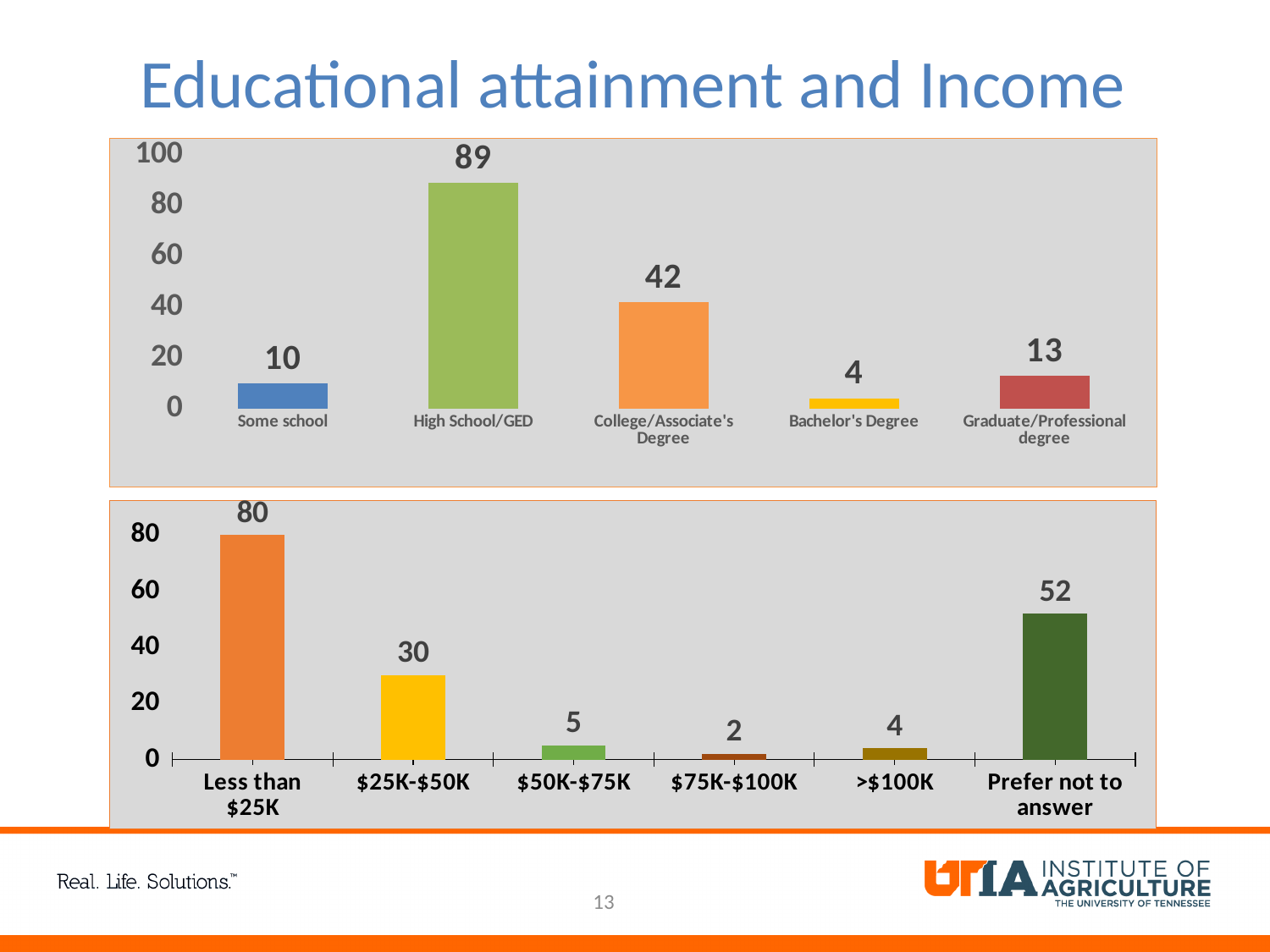
In the bottom chart (income), which category has the lowest value? $75K-$100K In the top chart (educational attainment), which is larger, the value for Some school or the value for Graduate/Professional degree? Graduate/Professional degree In the top chart (educational attainment), how many categories are shown? 5 What type of chart is the bottom chart (income)? Bar chart In the top chart (educational attainment), which category has the lowest value? Bachelor's Degree In the bottom chart (income), what is the difference between the values for Less than $25K and Prefer not to answer? 28 In the top chart (educational attainment), what is the value for High School/GED? 89 In the bottom chart (income), what is the value for Less than $25K? 80 What is the title of the slide? Educational attainment and Income In the top chart (educational attainment), what is the difference between the values for High School/GED and College/Associate's Degree? 47 In the bottom chart (income), how many categories are shown? 6 In the bottom chart (income), which category has the highest value? Less than $25K